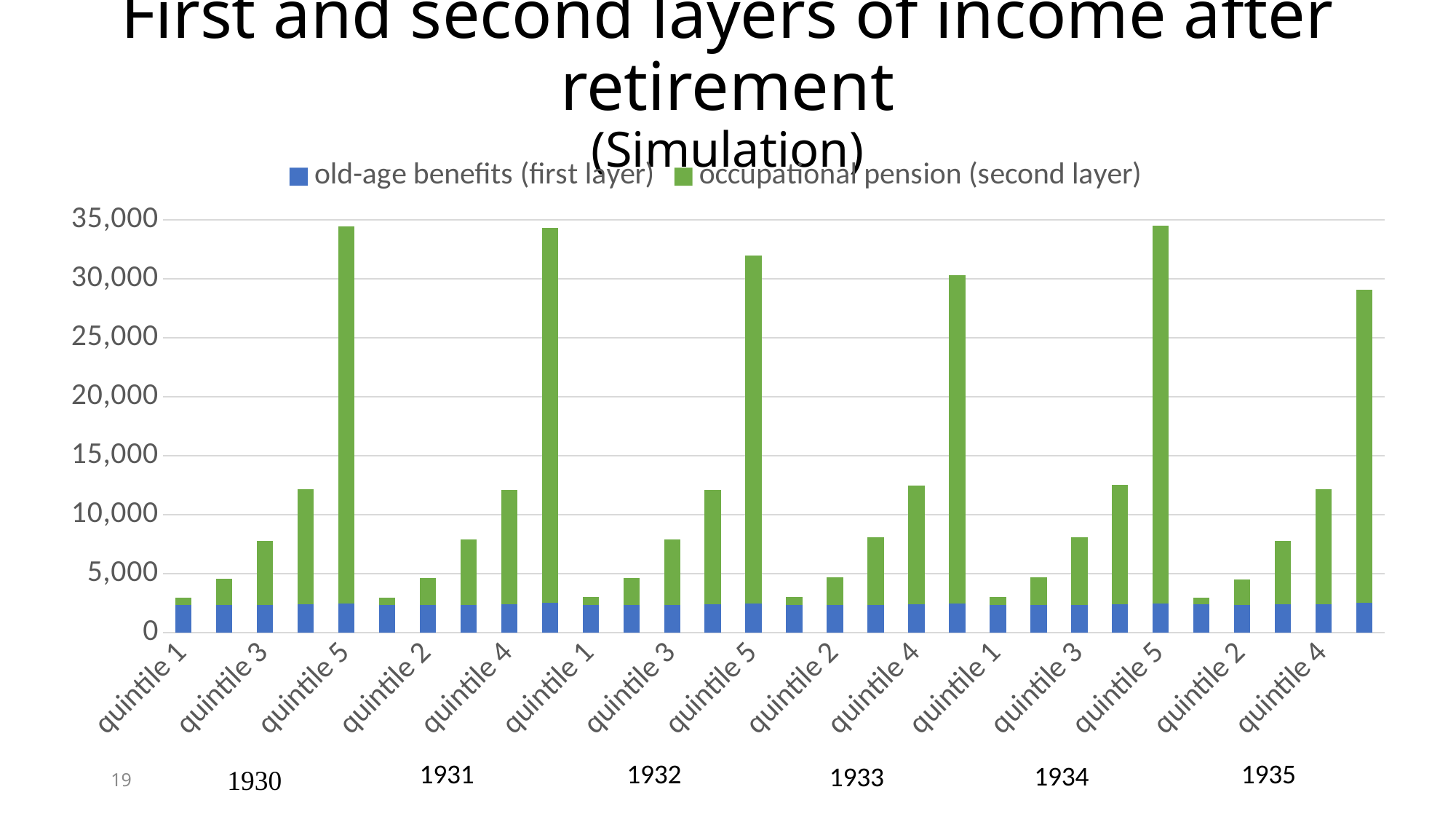
Within 1935, which quintile has the highest total bar? Quintile 5 Which series is shown in green in the chart? occupational pension (second layer) What kind of chart is shown on the slide? Stacked bar chart Which has the larger total, quintile 5 in 1930 or quintile 5 in 1935? Quintile 5 in 1930 Is the total value for quintile 5 in 1932 greater or less than 30,000? greater Is the total value for quintile 4 in 1930 greater or less than 10,000? greater Is the total value for quintile 1 in 1930 greater or less than 5,000? less How many years are shown along the x axis of the chart? 6 How many series does the legend list? 2 Within 1930, which quintile has the lowest total bar? Quintile 1 How many bars are plotted in the chart? 30